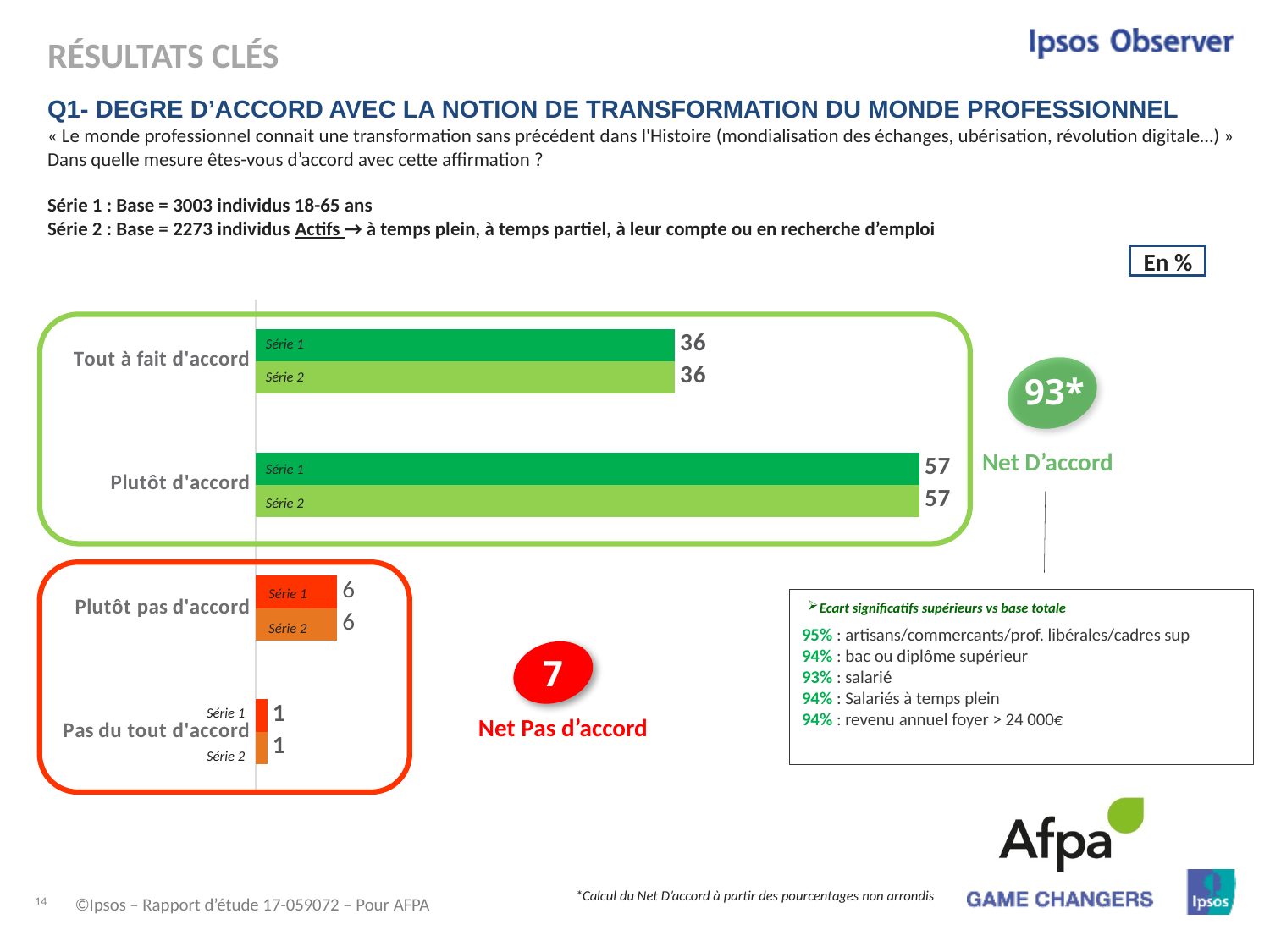
What is the Série 1 value for "Plutôt d'accord"? 57 Which is larger for Série 2: "Plutôt pas d'accord" or "Pas du tout d'accord"? Plutôt pas d'accord Which category has the highest Série 1 value? Plutôt d'accord Which category has the lowest Série 2 value? Pas du tout d'accord What unit are the chart values expressed in, according to the box at the top right of the chart? En % What is the difference between the Série 1 values for "Plutôt d'accord" and "Tout à fait d'accord"? 21 What is the Série 2 value for "Tout à fait d'accord"? 36 What is the Série 2 value for "Pas du tout d'accord"? 1 How many response categories are shown in the chart? 4 What type of chart is shown on the slide? Bar chart How many series are plotted for each category? 2 What is the Série 1 value for "Plutôt pas d'accord"? 6